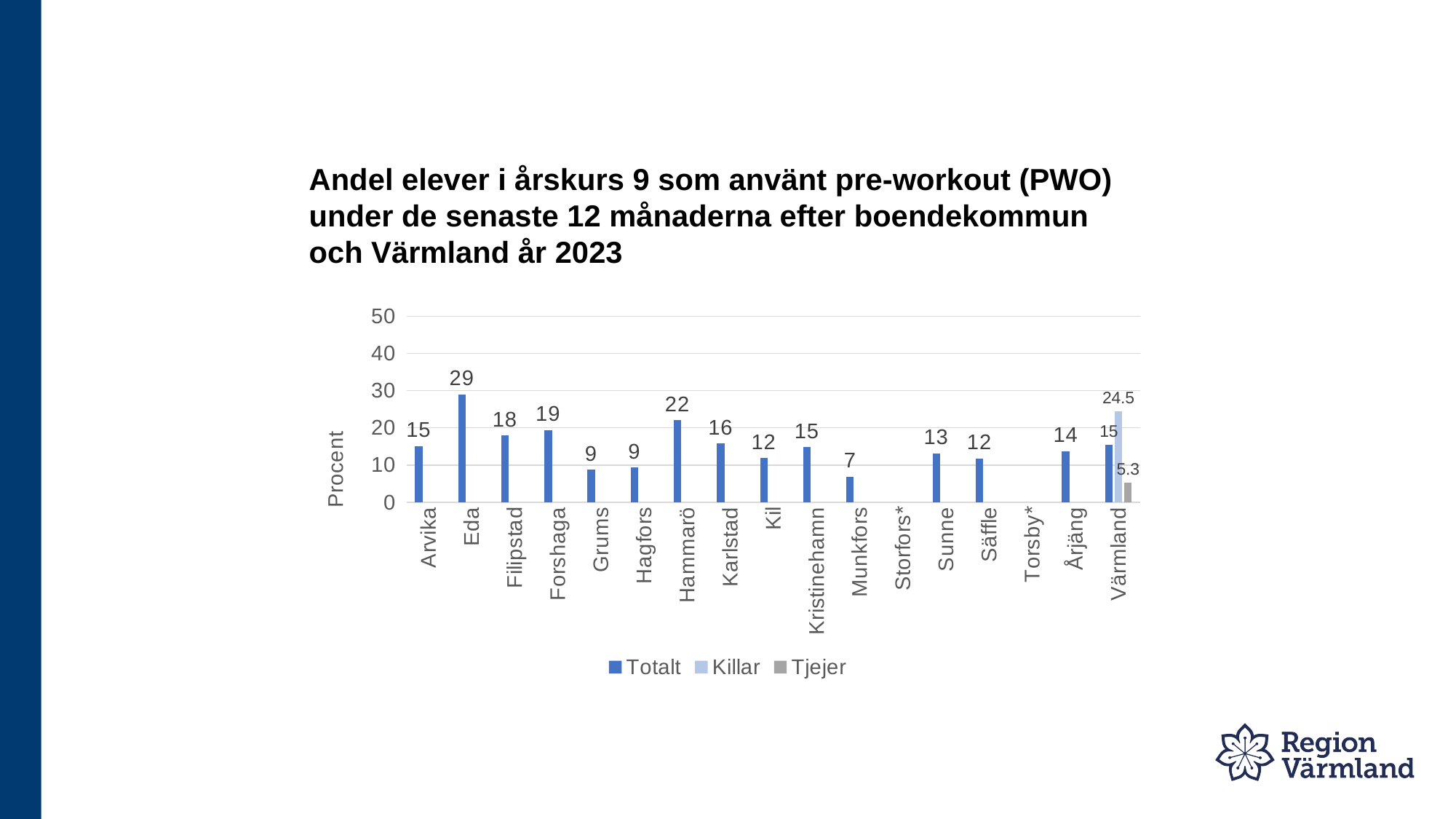
How many categories are shown on the x axis? 17 What is the difference between the Totalt values for Hammarö and Karlstad? 6 Is the Totalt value for Eda greater or less than 20? greater What kind of chart is shown on the slide? bar chart What is the Totalt value for Eda? 29 Which municipality has the highest Totalt value? Eda Which has a larger Totalt value, Filipstad or Forshaga? Forshaga How many series does the legend list? 3 Among the municipalities with a plotted bar, which has the lowest Totalt value? Munkfors What is the Tjejer value for Värmland? 5.3 What is the Killar value for Värmland? 24.5 What is the label of the y axis? Procent